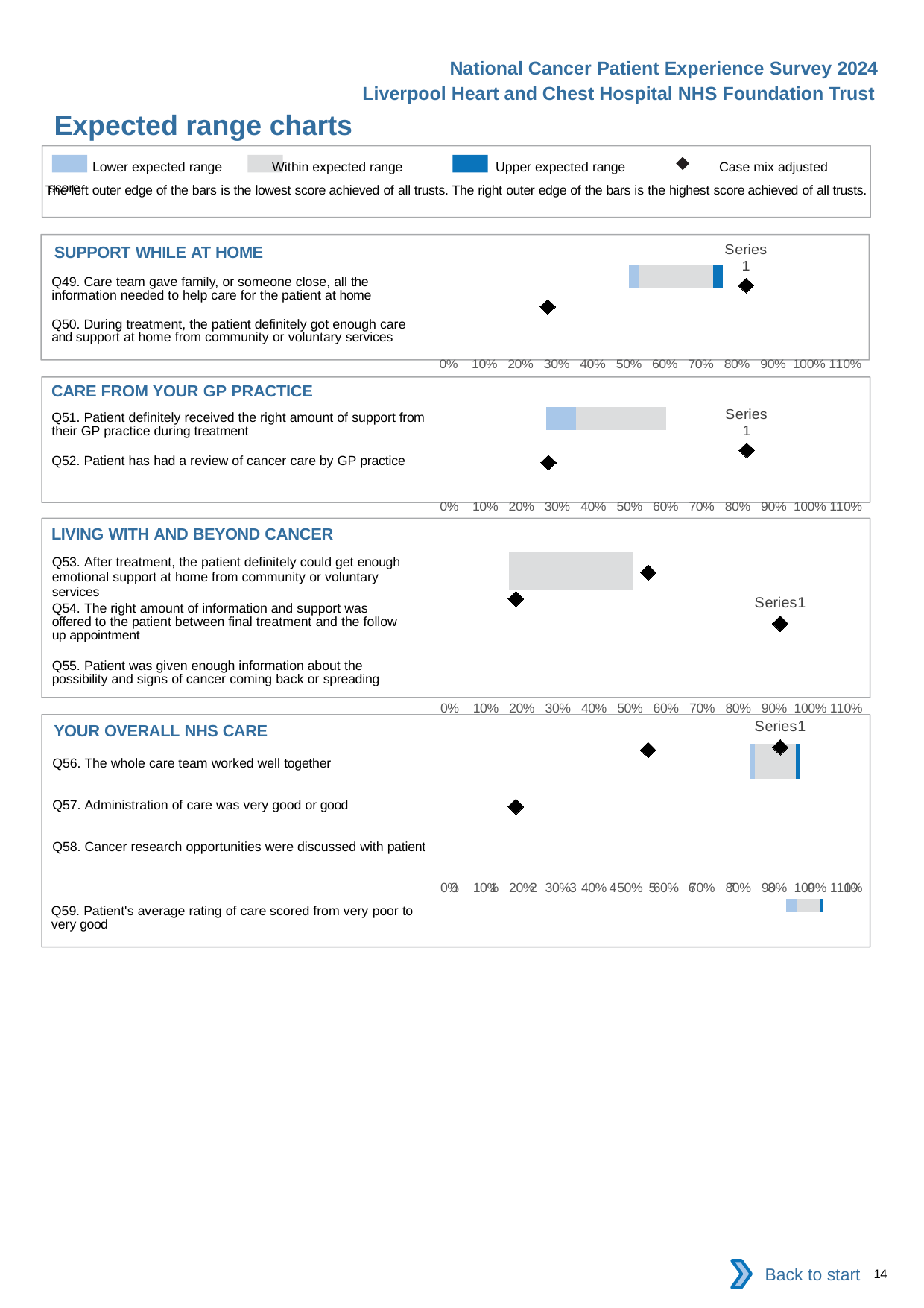
According to the legend, what does the diamond marker represent? Case mix adjusted score What is the highest tick label shown on the x axis of the CARE FROM YOUR GP PRACTICE chart? 110% In the SUPPORT WHILE AT HOME chart, is the right edge of the shaded bar greater or less than 70%? greater What kind of chart is used in the SUPPORT WHILE AT HOME section? Bar chart In the LIVING WITH AND BEYOND CANCER chart, is the left edge of the shaded bar greater or less than 30%? less How many questions are listed in the YOUR OVERALL NHS CARE chart? 4 How many questions are listed in the SUPPORT WHILE AT HOME chart? 2 How many entries does the legend at the top of the slide list? 4 How many questions are listed in the LIVING WITH AND BEYOND CANCER chart? 3